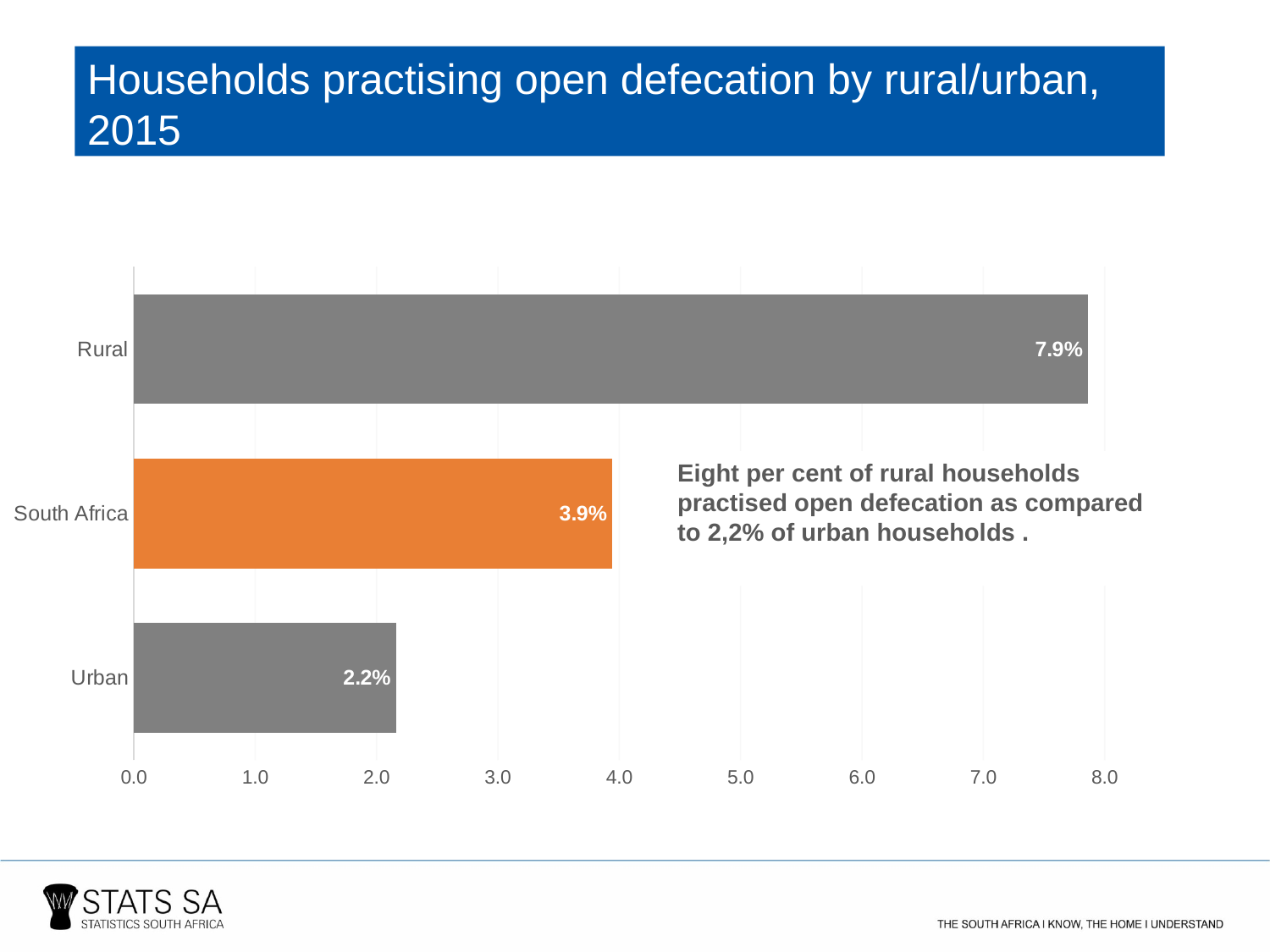
What is the value for Urban? 2.2% What is the value for Rural? 7.9% What is the value for South Africa? 3.9% What is the difference between the Rural and South Africa values? 4.0% Which category has the lowest value? Urban Which is larger, the value for South Africa or the value for Urban? South Africa How many categories are shown in the chart? 3 What kind of chart is shown on the slide? Bar chart Is the value for Rural greater or less than 7.0? greater What is the title of the chart on the slide? Households practising open defecation by rural/urban, 2015 What is the difference between the Rural and Urban values? 5.7% Which category has the highest value? Rural